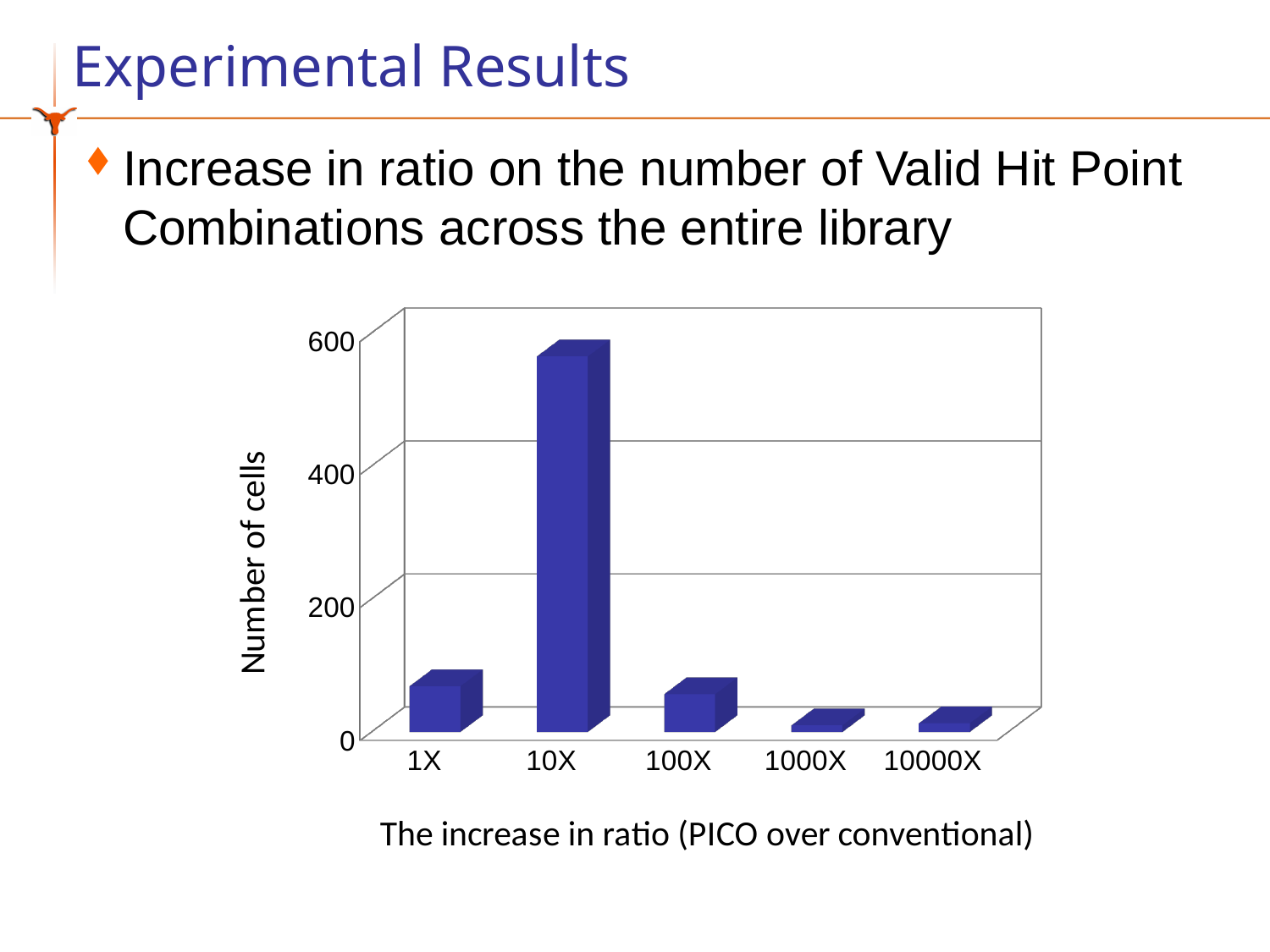
How many categories are shown on the x axis of the chart? 5 Do the values rise or fall along the x axis from 10X to 1000X? fall Is the value for 1X greater or less than 200? less Is the value for 10X greater or less than 400? greater What kind of chart is shown on the slide? bar chart Is the value for 100X greater or less than 200? less What is the label of the vertical axis of the chart? Number of cells Which category has the highest number of cells? 10X Which has a larger number of cells, 10X or 1X? 10X What is the label of the horizontal axis of the chart? The increase in ratio (PICO over conventional) Which has a larger number of cells, 100X or 1000X? 100X